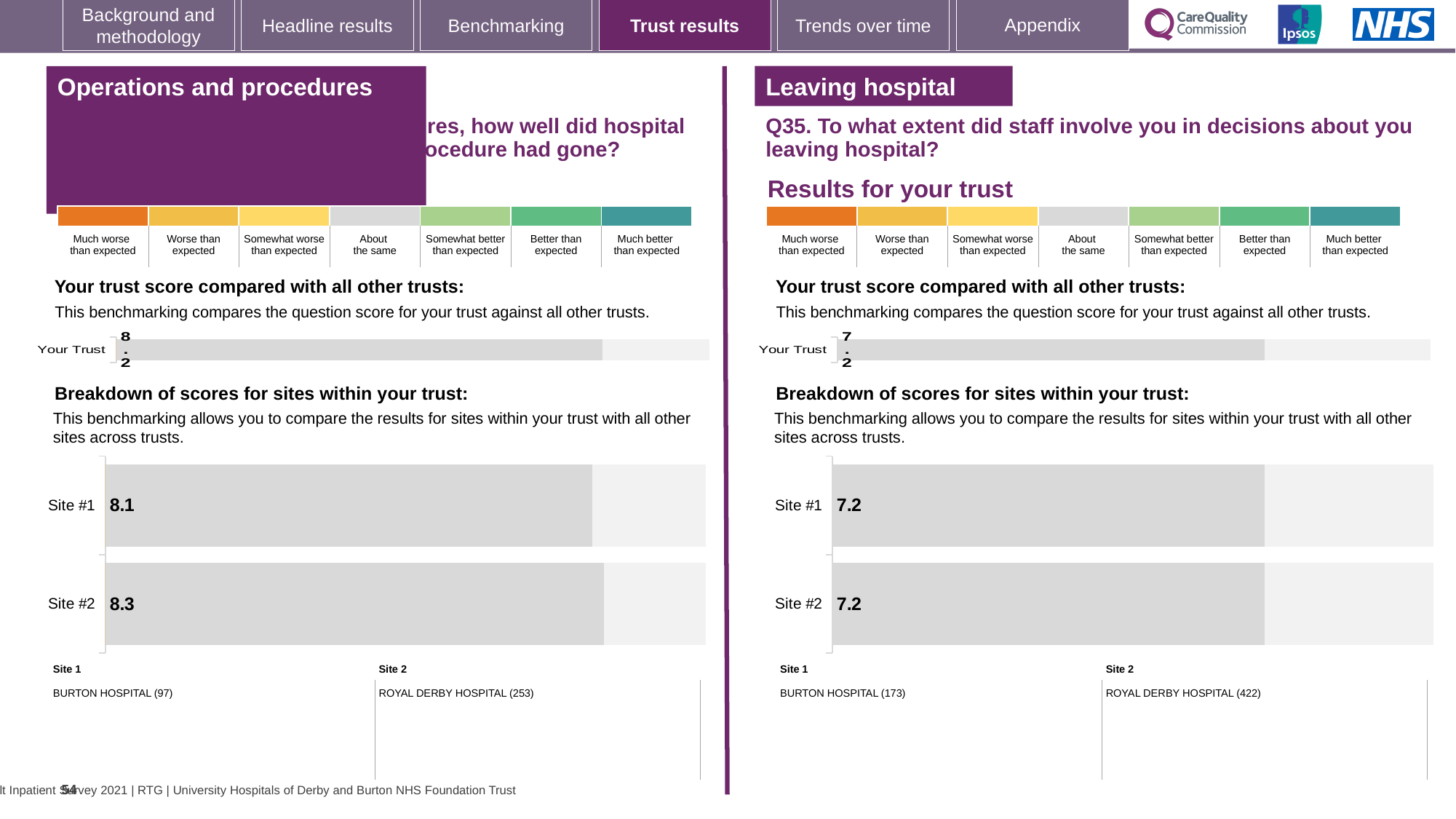
On the 'Leaving hospital' site breakdown chart on the right, what is the score for Site #2? 7.2 Is the Site #1 score on the 'Operations and procedures' chart on the left larger or smaller than the Site #1 score on the 'Leaving hospital' chart on the right? Larger On the 'Leaving hospital' site breakdown chart on the right, what is the score for Site #1? 7.2 On the 'Operations and procedures' site breakdown chart on the left, what is the score for Site #2? 8.3 On the 'Operations and procedures' 'Your Trust' chart on the left, what is the trust score? 8.2 On the 'Operations and procedures' site breakdown chart on the left, what is the difference between the Site #2 and Site #1 scores? 0.2 How many sites are shown on the 'Leaving hospital' site breakdown chart on the right? 2 On the 'Operations and procedures' site breakdown chart on the left, which site has the higher score? Site #2 What type of chart is the 'Operations and procedures' site breakdown chart on the left? Bar chart On the 'Leaving hospital' 'Your Trust' chart on the right, what is the trust score? 7.2 On the 'Leaving hospital' site breakdown chart on the right, what is the difference between the Site #1 and Site #2 scores? 0 On the 'Operations and procedures' site breakdown chart on the left, what is the score for Site #1? 8.1